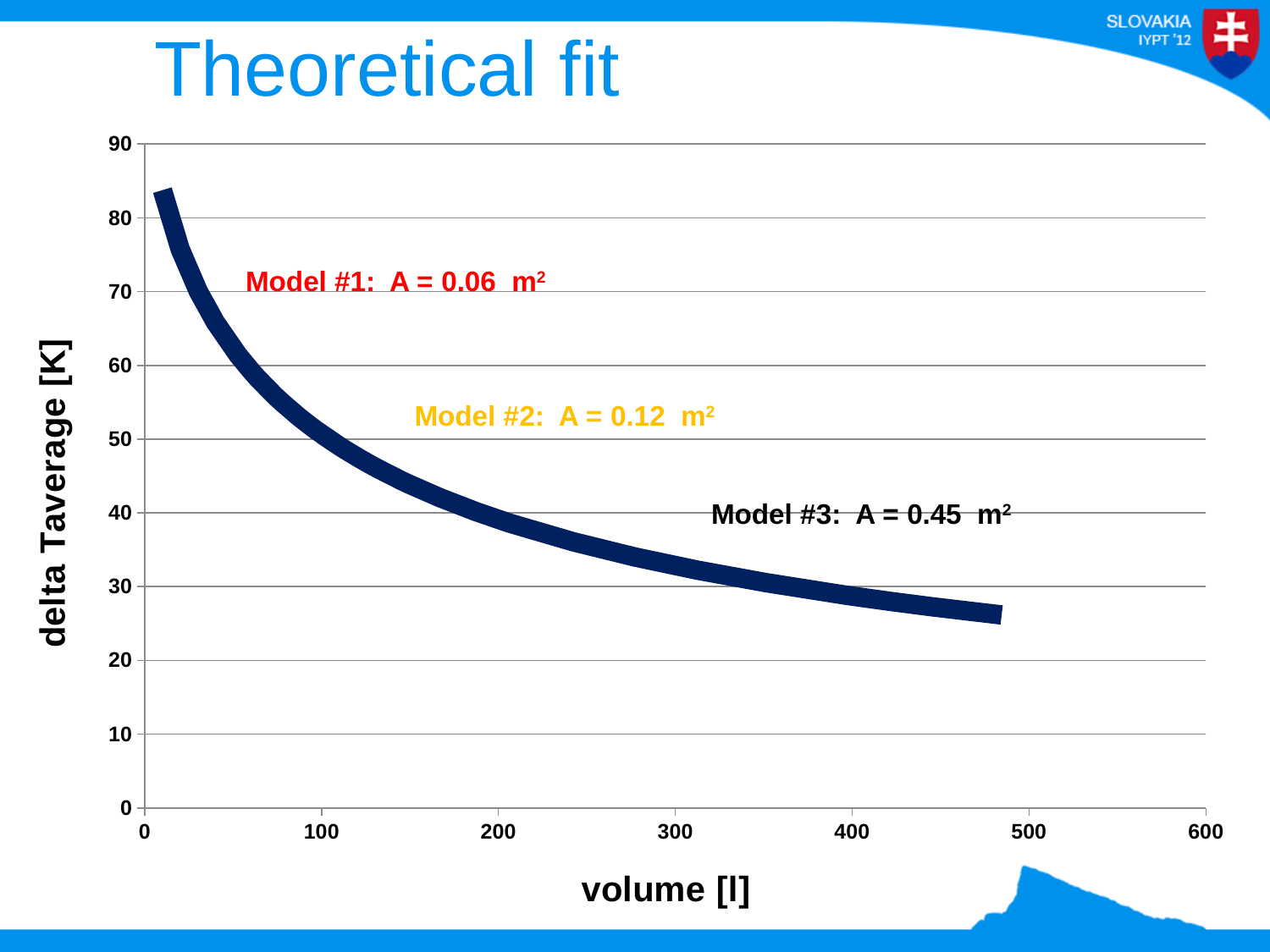
What is the highest tick value shown on the y axis? 90 What value of A is given for Model #3 in the chart annotation? 0.45 m² Is the value of delta Taverage at a volume of 50 l greater or less than 60? greater Does delta Taverage rise or fall as volume increases along the x axis? fall Is the value of delta Taverage at a volume of 300 l greater or less than 30? greater Is the value of delta Taverage at a volume of 100 l greater or less than 60? less What is the title of the slide containing the chart? Theoretical fit What kind of chart is shown on the slide? line chart